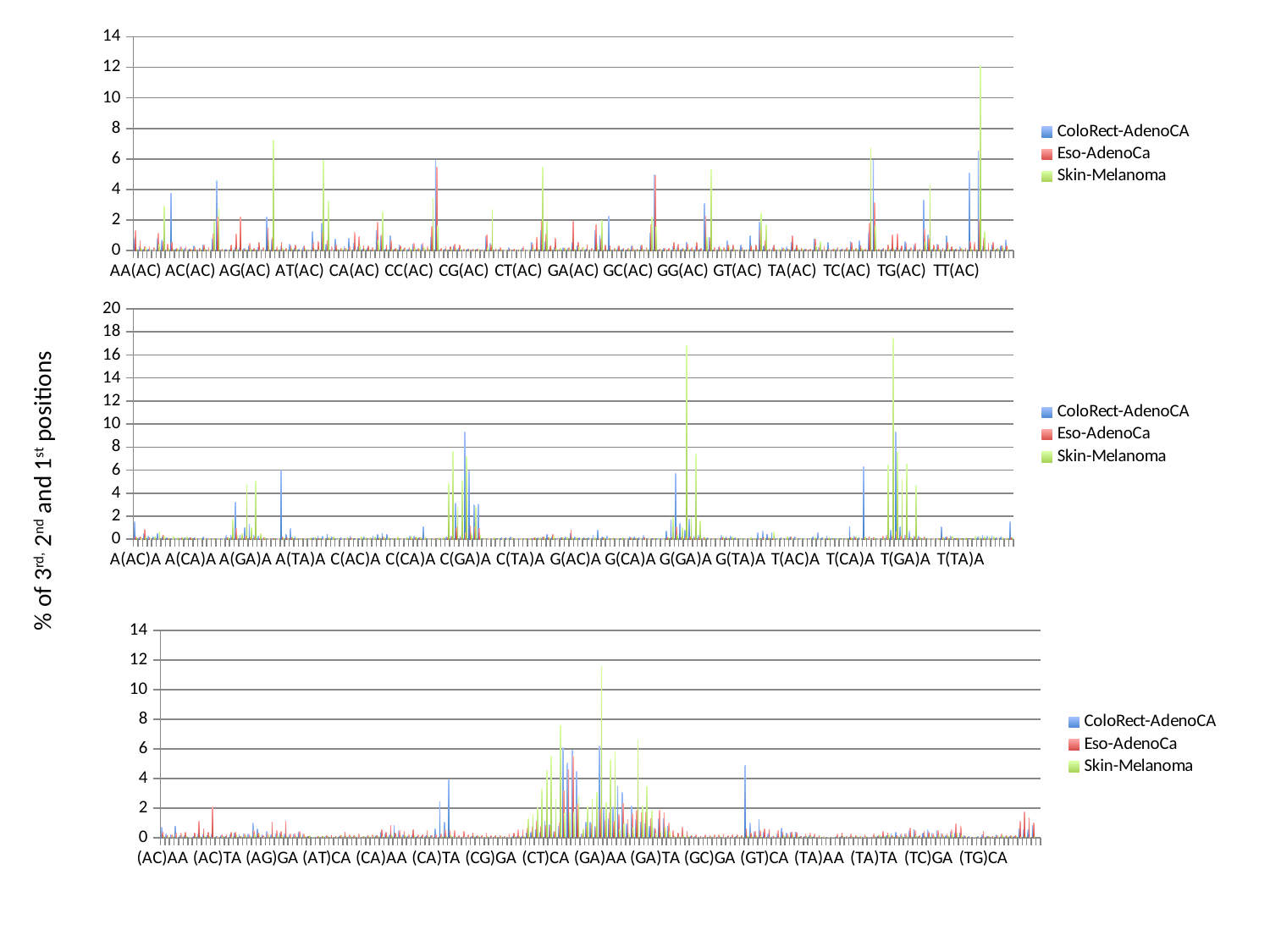
In the middle chart, is the tallest ColoRect-AdenoCA bar near C(GA)A greater or less than 8? greater How many series does the legend of the top chart list? 3 What kind of chart is the top chart on the slide? bar chart Which series are listed in the legend of the middle chart? ColoRect-AdenoCA, Eso-AdenoCa, Skin-Melanoma In the top chart, is the tallest Eso-AdenoCa bar near GG(AC) greater or less than 8? less What is the maximum value shown on the y axis of the middle chart? 20 In the top chart, which series has the single tallest bar? Skin-Melanoma In the bottom chart, is the tallest ColoRect-AdenoCA bar near (GT)CA greater or less than 4? greater In the middle chart, which series has the single tallest bar? Skin-Melanoma